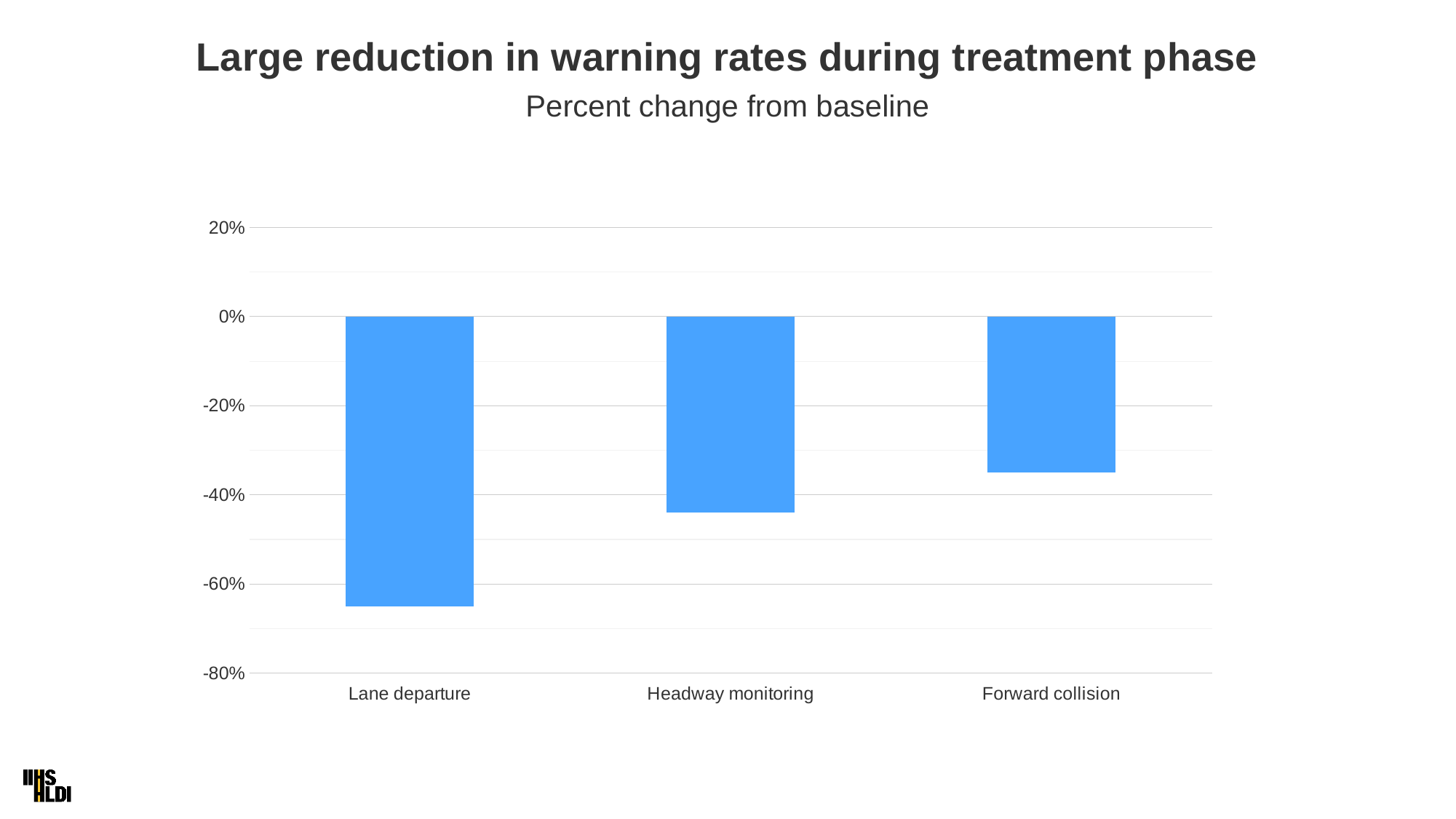
Which category shows the lowest value (largest reduction) in the chart? Lane departure What is the subtitle of the chart? Percent change from baseline Which category shows the highest value (smallest reduction) in the chart? Forward collision How many categories are shown on the x axis of the chart? 3 Is the value for Headway monitoring greater or less than -40%? less Which has the larger value, Headway monitoring or Forward collision? Forward collision Is the value for Headway monitoring greater or less than -60%? greater Is the value for Forward collision greater or less than -20%? less What kind of chart is shown on the slide? bar chart Do the values rise or fall moving from left to right along the x axis? rise